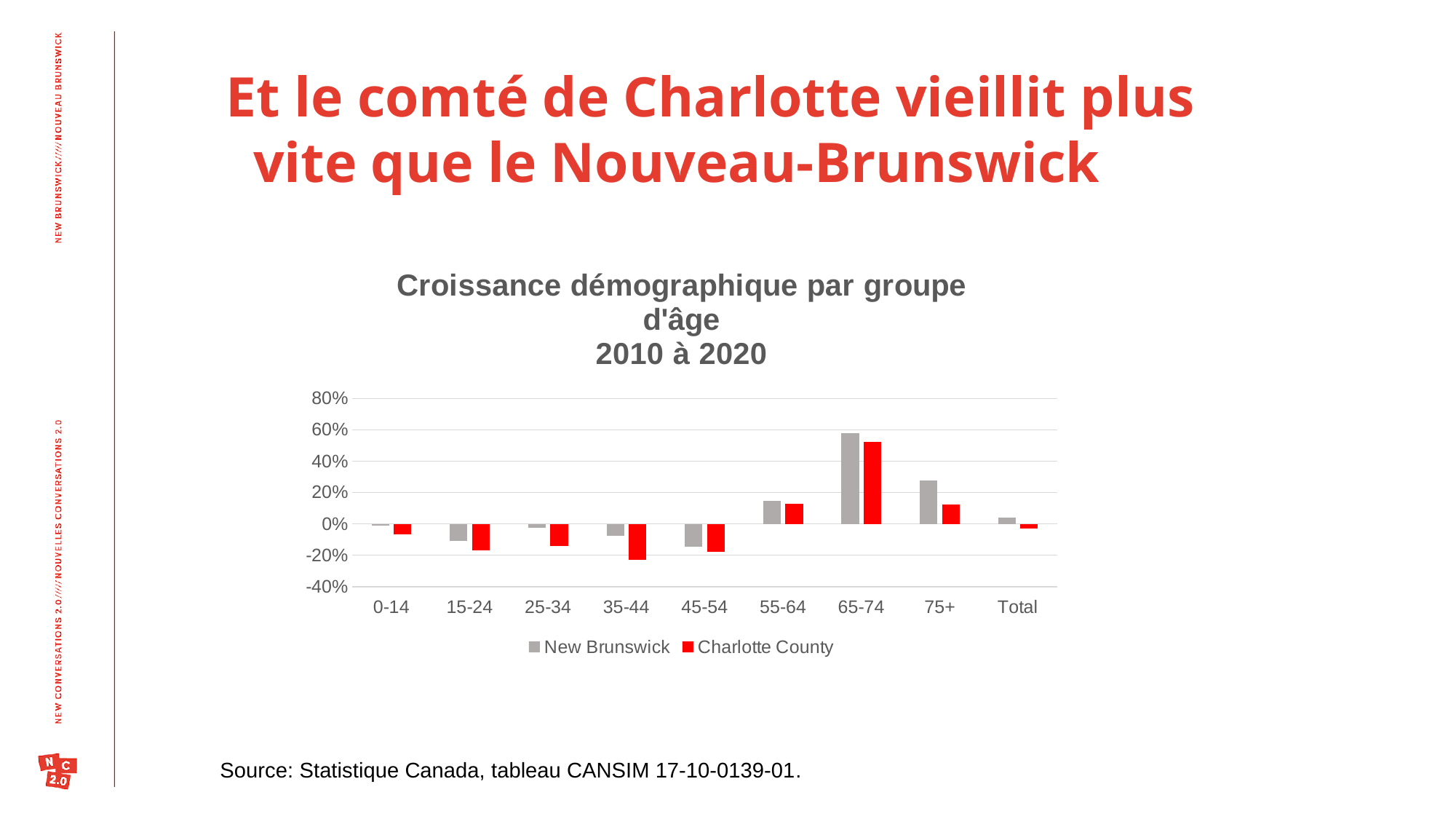
How many age-group categories are shown on the x axis, including Total? 9 How many series does the legend list? 2 Which category has the lowest value for Charlotte County? 35-44 For the 65-74 group, which series has the larger value, New Brunswick or Charlotte County? New Brunswick Is the New Brunswick value for 65-74 greater or less than 40%? greater Is the Charlotte County value for 35-44 greater or less than -20%? less Which category has the lowest value for New Brunswick? 45-54 What kind of chart is shown on the slide? bar chart For the 75+ group, which series has the larger value, New Brunswick or Charlotte County? New Brunswick Which colour represents Charlotte County in the chart? red Which category has the highest value for New Brunswick? 65-74 Which category has the highest value for Charlotte County? 65-74